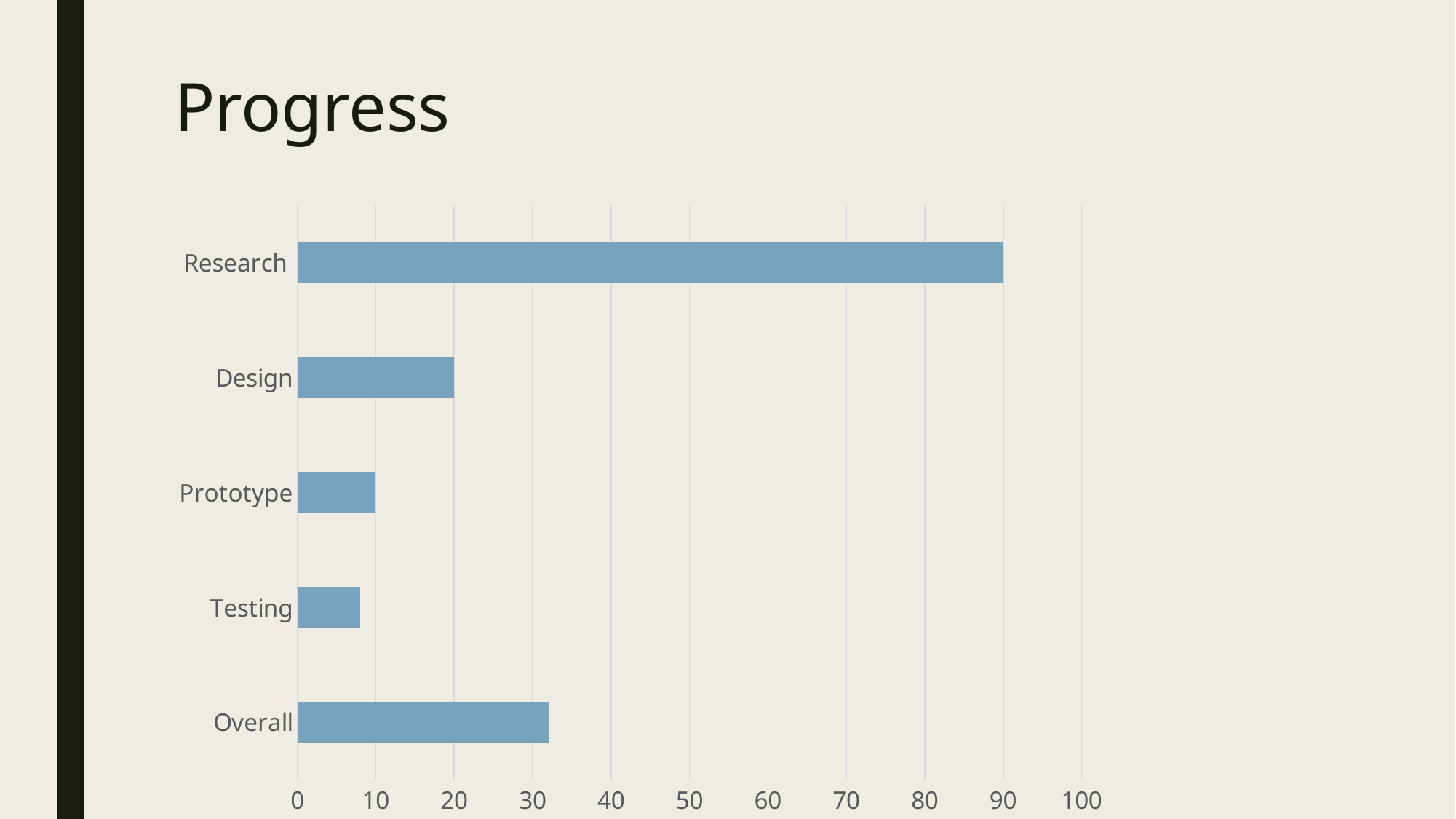
Which is larger, the value for Overall or the value for Design? Overall What is the value for Design? 20 What is the title of the chart? Progress What type of chart is shown on the slide? bar chart How many categories are shown in the chart? 5 What is the difference between the values for Research and Design? 70 Is the value for Overall greater or less than 30? greater What is the value for Research? 90 Which category has the highest value? Research What is the value for Prototype? 10 Is the value for Testing greater or less than 10? less Which category has the lowest value? Testing